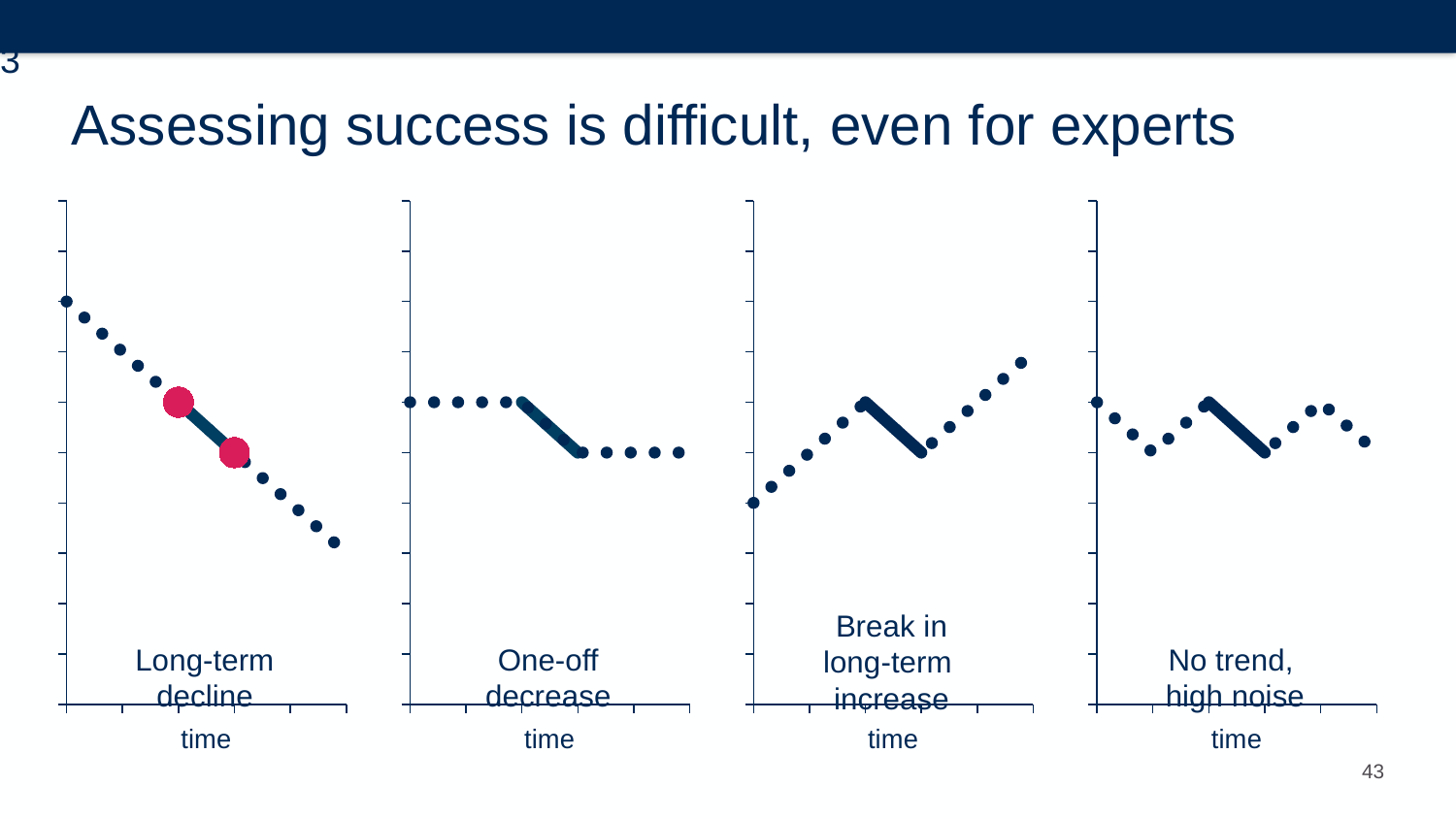
In the leftmost chart labelled "Long-term decline", do the values rise or fall along the x axis? fall In the leftmost chart labelled "Long-term decline", how many points are highlighted in red? 2 In the second chart labelled "One-off decrease", are the values at the end of the series higher or lower than at the start? lower What is the label of the rightmost chart? No trend, high noise In the third chart labelled "Break in long-term increase", do the values overall rise or fall from the first point to the last point? rise In the third chart labelled "Break in long-term increase", is the last point higher or lower than the first point? higher How many charts are shown on the slide? 4 What kind of chart is the leftmost chart labelled "Long-term decline"? scatter chart In the leftmost chart labelled "Long-term decline", is the first point higher or lower than the last point? higher What is the x-axis label on each of the four charts? time